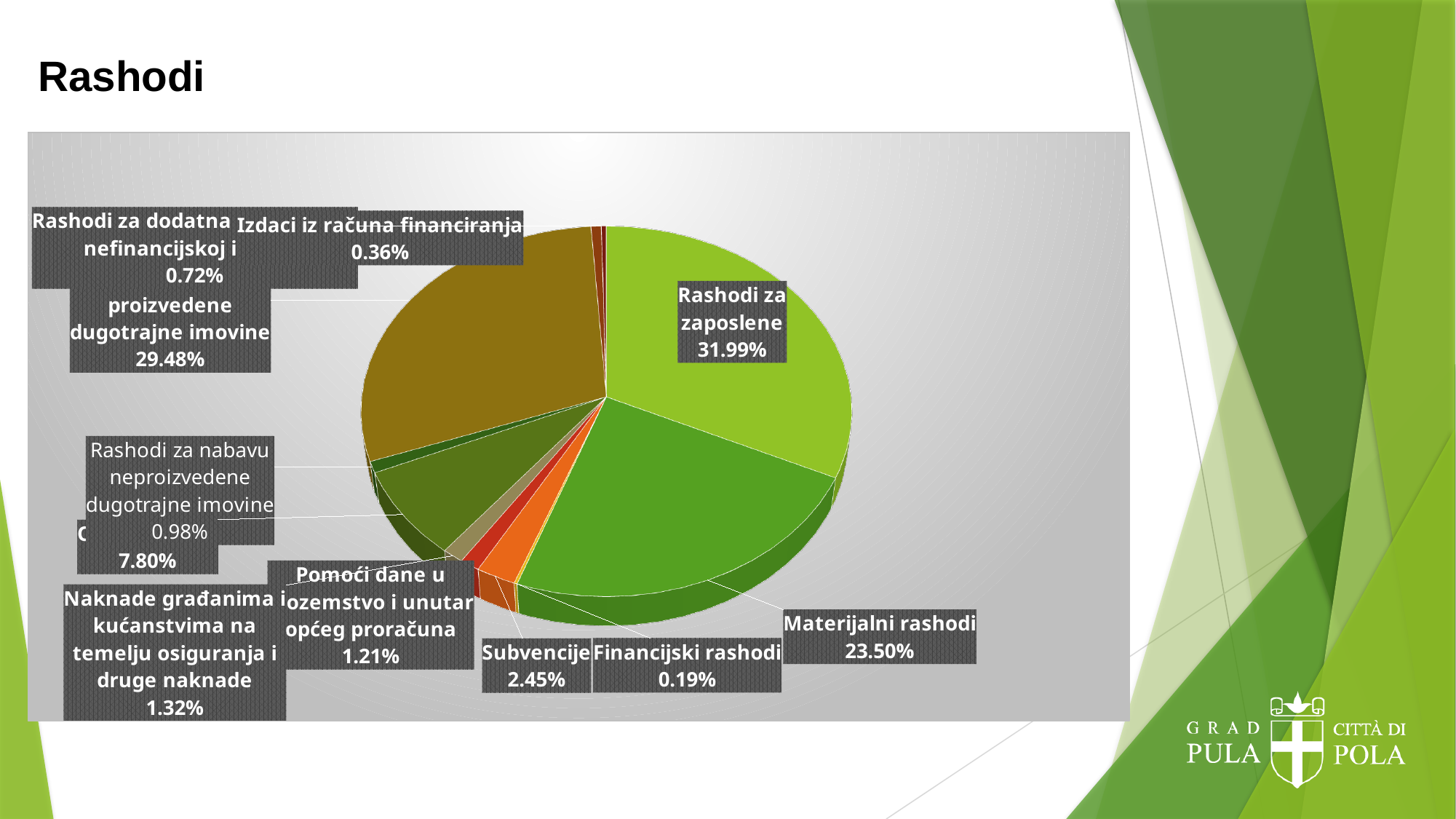
What percentage is shown for Subvencije? 2.45% Which category has the smallest share of the pie? Financijski rashodi Which category has the largest share of the pie? Rashodi za zaposlene What percentage is shown for Financijski rashodi? 0.19% What share of the pie is labelled for Rashodi za zaposlene? 31.99% What is the difference in percentage points between Rashodi za zaposlene and Materijalni rashodi? 8.49 Which is larger: Subvencije or Pomoći dane u inozemstvo i unutar općeg proračuna? Subvencije What percentage is shown for Materijalni rashodi? 23.50% What kind of chart is shown on the slide? Pie chart How many slices does the pie chart have? 11 What is the title of the slide's chart? Rashodi What percentage is shown for Izdaci iz računa financiranja? 0.36%